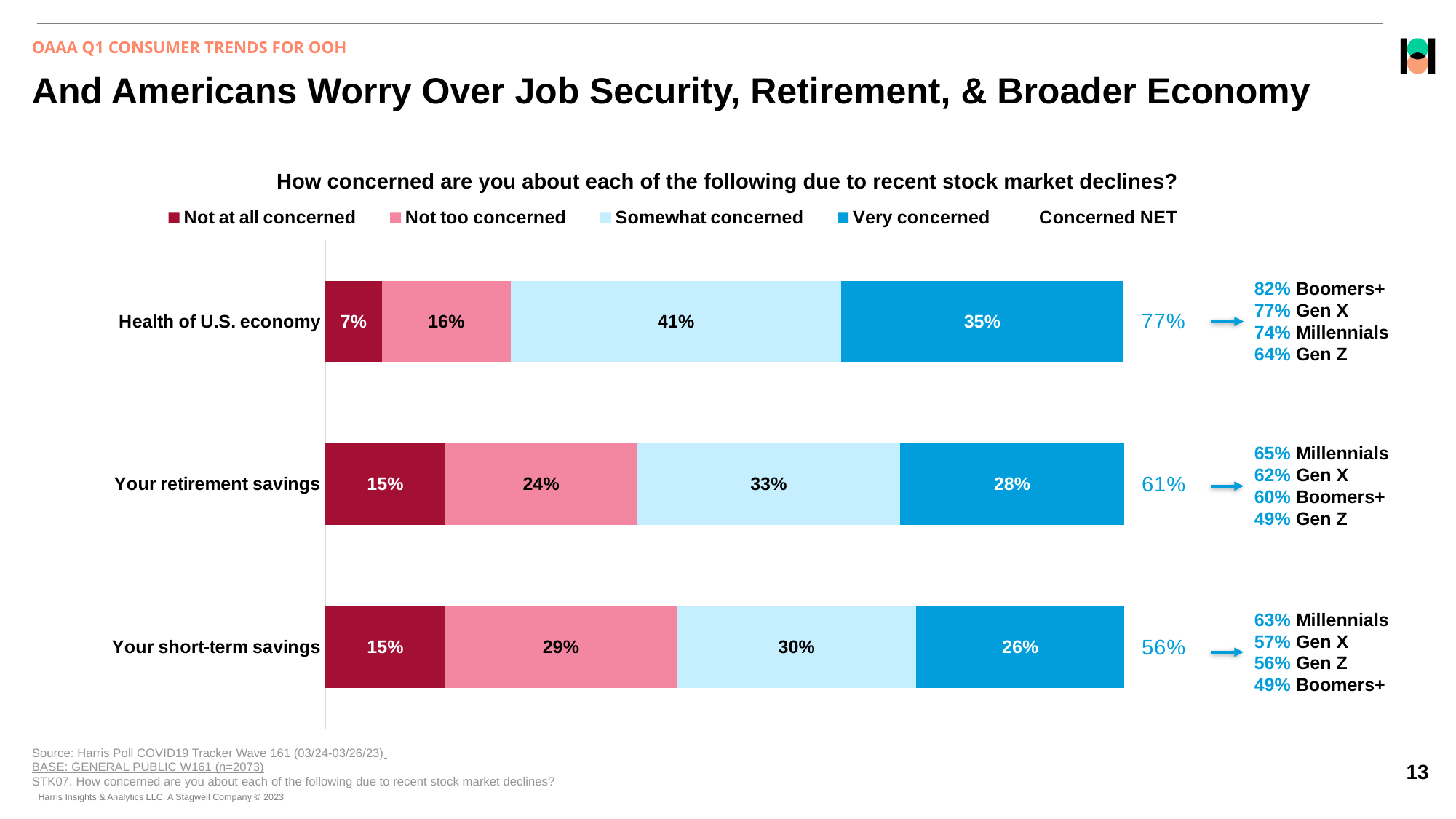
What is the combined 'Somewhat concerned' and 'Very concerned' total for 'Your short-term savings'? 56% How many items (categories) are shown in the chart? 3 Which generation has the highest Concerned NET for 'Health of U.S. economy'? Boomers+ (82%) What is the difference between the Concerned NET for 'Health of U.S. economy' and 'Your short-term savings'? 21% What percentage of respondents are 'Very concerned' about the health of the U.S. economy? 35% Which item has the lowest 'Very concerned' percentage? Your short-term savings What percentage of respondents are 'Not too concerned' about their short-term savings? 29% Which is larger: the 'Somewhat concerned' share for 'Your retirement savings' or for 'Your short-term savings'? Your retirement savings What type of chart is shown on the slide? Stacked bar chart How many response categories does the legend list, excluding Concerned NET? 4 Which item has the highest Concerned NET value? Health of U.S. economy What is the Concerned NET value for 'Your retirement savings'? 61%